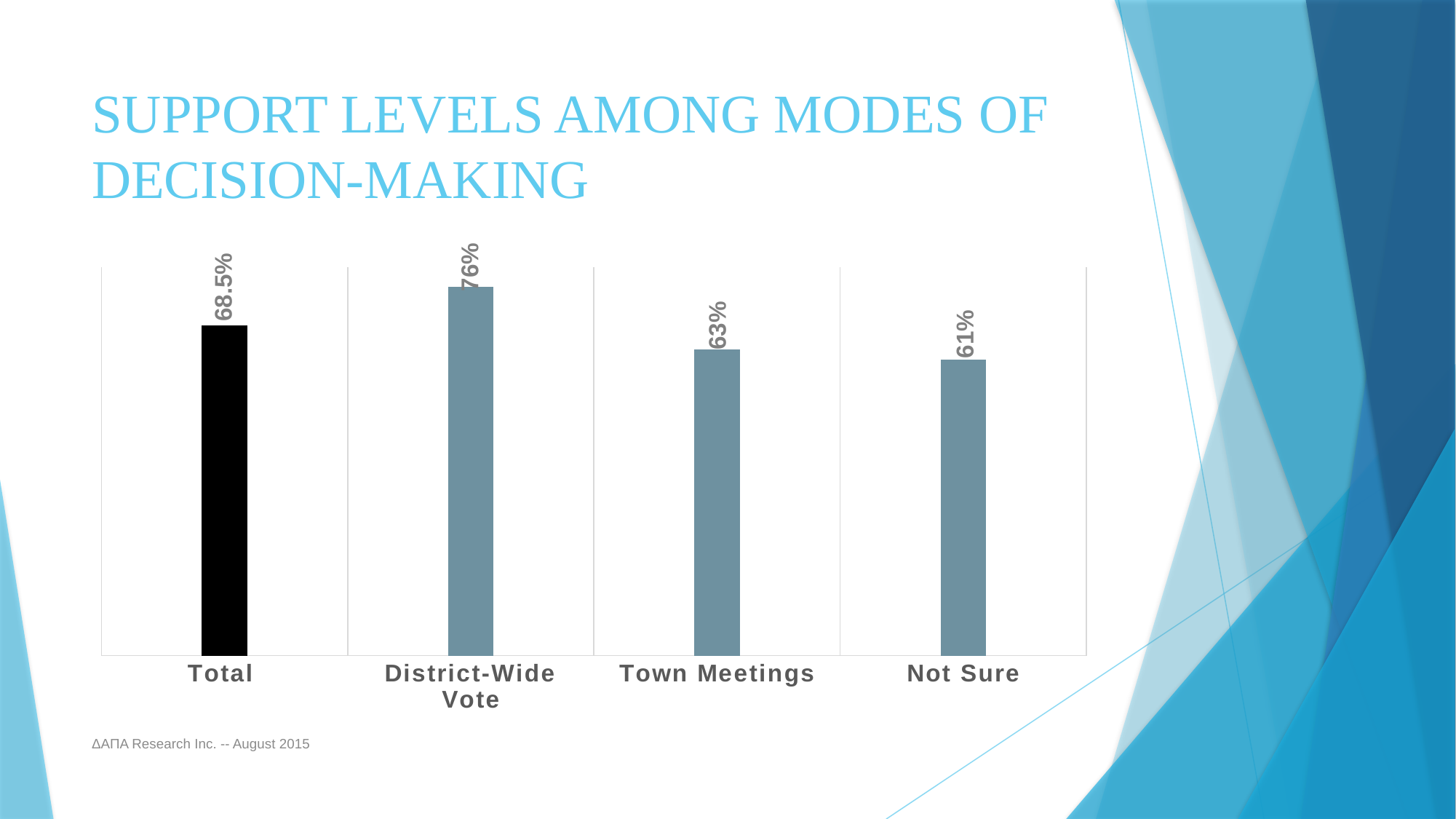
What is the support level for District-Wide Vote? 76% How many categories are shown on the x axis? 4 What is the value shown for Total? 68.5% Which is larger, the value for Town Meetings or the value for Not Sure? Town Meetings Which bar is coloured black? Total Which category has the highest support level? District-Wide Vote What is the value shown for Not Sure? 61% What kind of chart is shown on the slide? Bar chart Which category has the lowest support level? Not Sure What is the difference between the Total value and the Not Sure value? 7.5% What is the support level for Town Meetings? 63% What is the difference between the District-Wide Vote and Town Meetings values? 13%